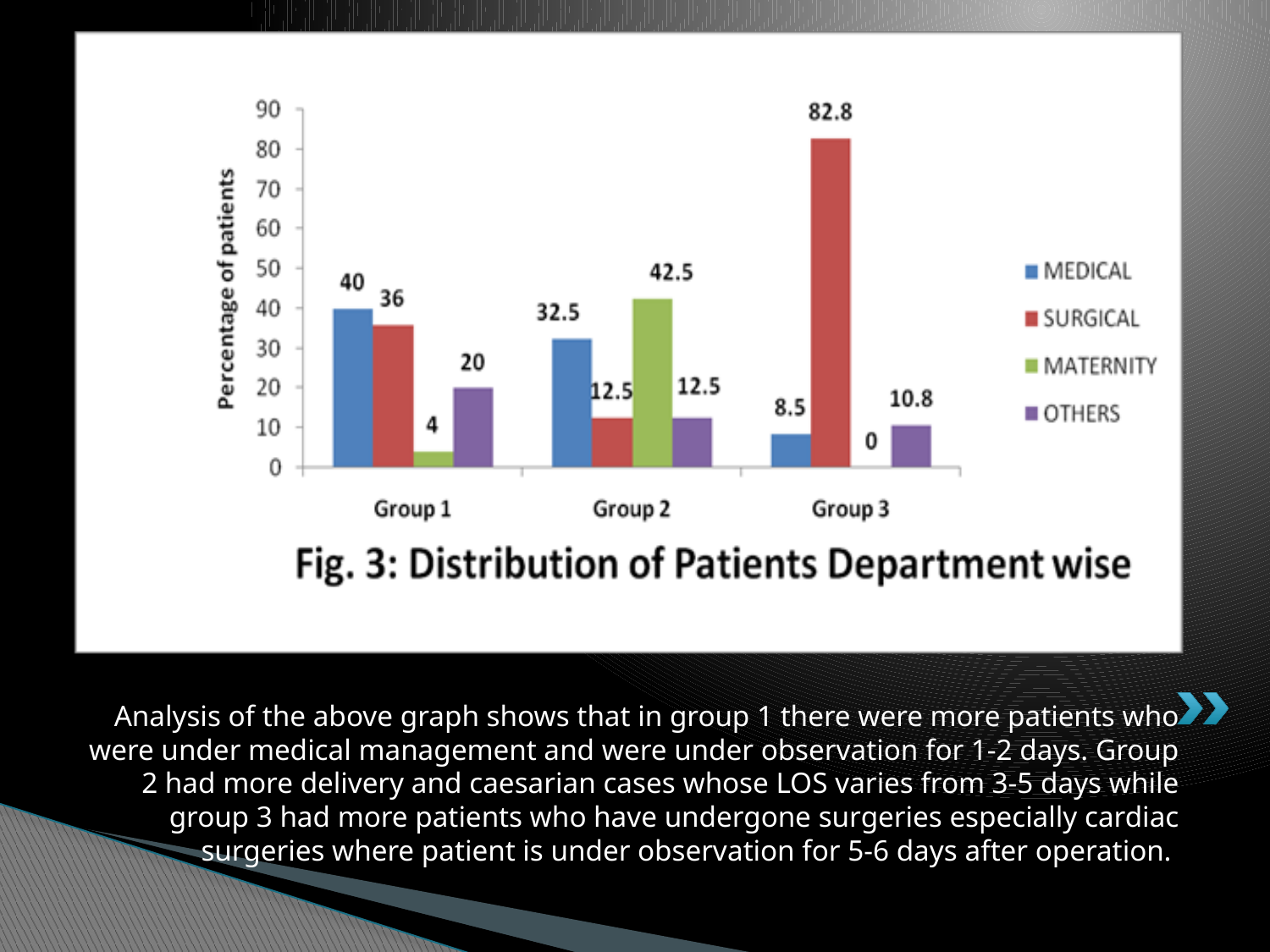
What is the value for MEDICAL in Group 3? 8.5 Which group has the highest MEDICAL value? Group 1 Which is larger in Group 2: MEDICAL or MATERNITY? MATERNITY What is the value for MATERNITY in Group 2? 42.5 What is the difference between the SURGICAL values for Group 3 and Group 1? 46.8 How many groups are shown on the x axis? 3 What is the value for OTHERS in Group 1? 20 How many series does the legend list? 4 What is the value for SURGICAL in Group 3? 82.8 Which group has the lowest MATERNITY value? Group 3 What kind of chart is shown? Bar chart What is the title of the chart? Fig. 3: Distribution of Patients Department wise